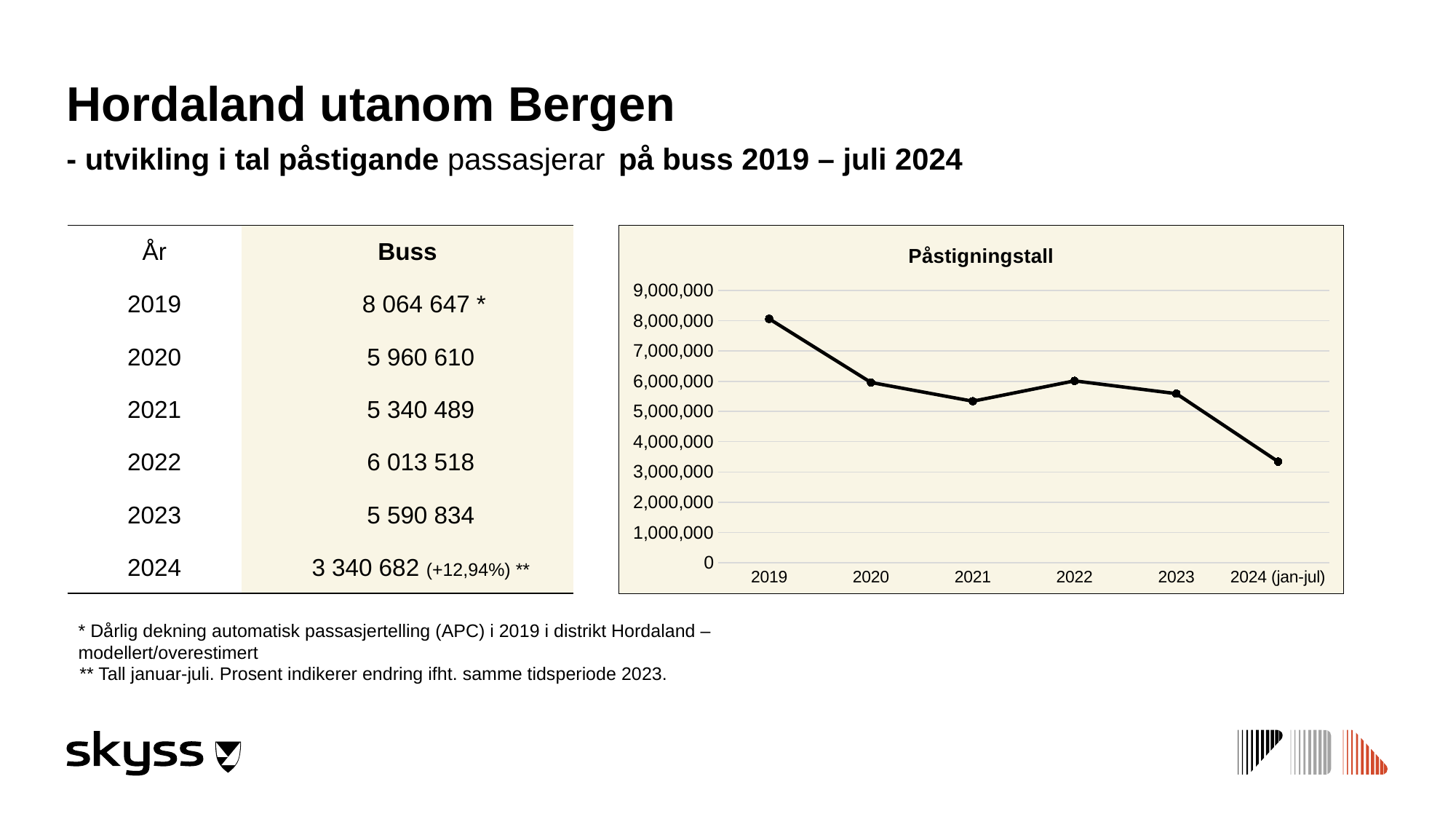
What is the value for 2022 on the chart? 6 013 518 Which year has the highest value on the chart? 2019 What is the title of the chart? Påstigningstall How many data points are plotted on the chart? 6 Is the value for 2021 greater or less than 6,000,000? less What is the value for 2021 on the chart? 5 340 489 What kind of chart is shown on the slide? line chart What is the value for 2024 (jan-jul) on the chart? 3 340 682 Is the value for 2024 (jan-jul) greater or less than 4,000,000? less Which is larger, the value for 2022 or the value for 2023? 2022 Which point on the chart has the lowest value? 2024 (jan-jul) What is the difference between the values for 2022 and 2021? 673 029